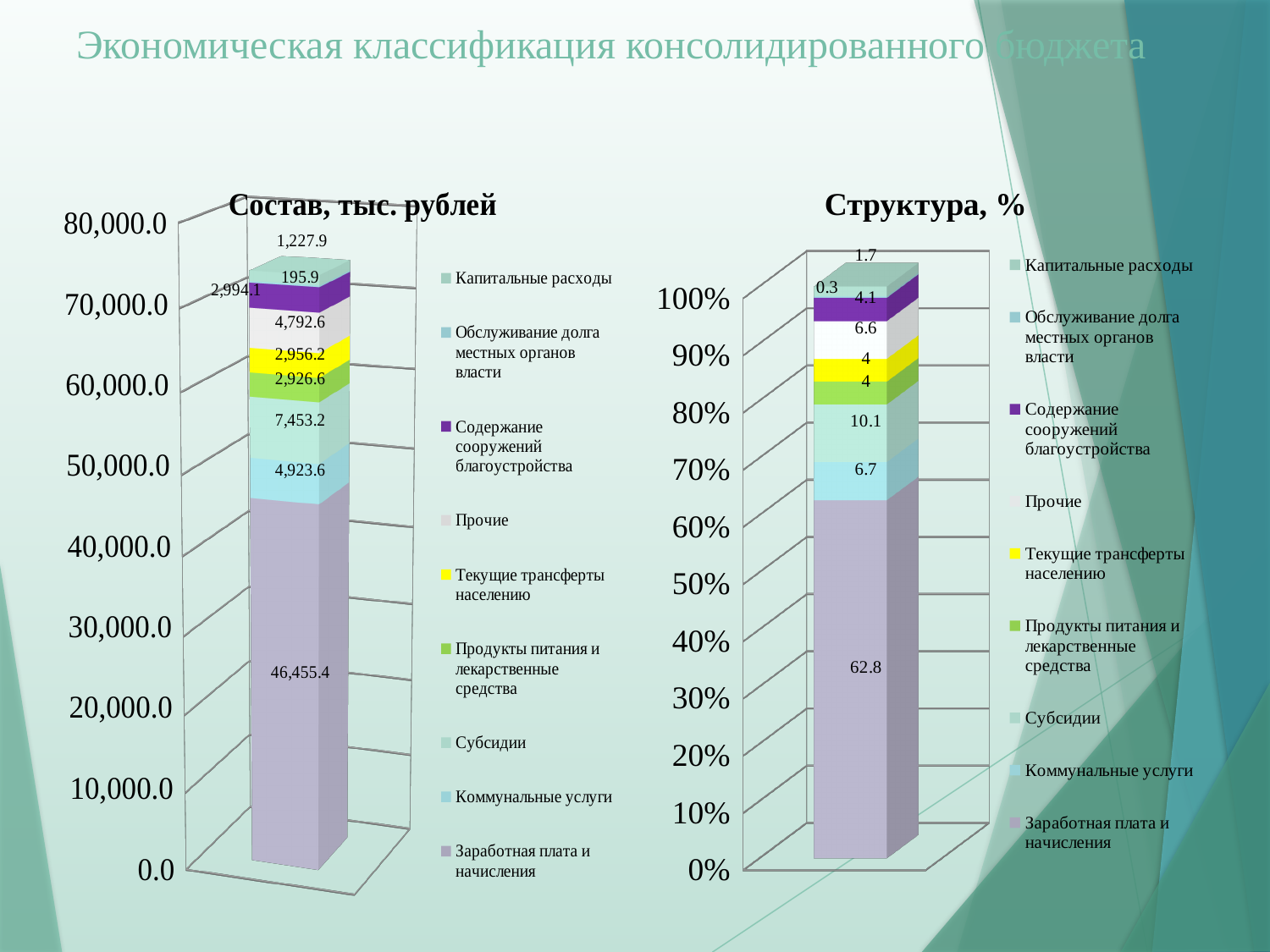
In the chart titled "Состав, тыс. рублей", what is the total of all segments in the stacked bar? 73,925.5 In the chart titled "Состав, тыс. рублей", which is larger: Прочие or Содержание сооружений благоустройства? Прочие In the chart titled "Состав, тыс. рублей", what is the difference between Субсидии and Коммунальные услуги? 2,529.6 In the chart titled "Состав, тыс. рублей", what is the value for Заработная плата и начисления? 46,455.4 In the chart titled "Структура, %", what is the share for Прочие? 6.6 In the chart titled "Состав, тыс. рублей", which category has the largest value? Заработная плата и начисления How many series does the legend of the chart titled "Структура, %" list? 9 In the chart titled "Состав, тыс. рублей", what is the value for Субсидии? 7,453.2 In the chart titled "Структура, %", what is the share for Заработная плата и начисления? 62.8 What kind of chart is the chart titled "Структура, %"? Stacked bar chart In the chart titled "Состав, тыс. рублей", which category has the smallest value? Обслуживание долга местных органов власти In the chart titled "Состав, тыс. рублей", what is the value for Обслуживание долга местных органов власти? 195.9